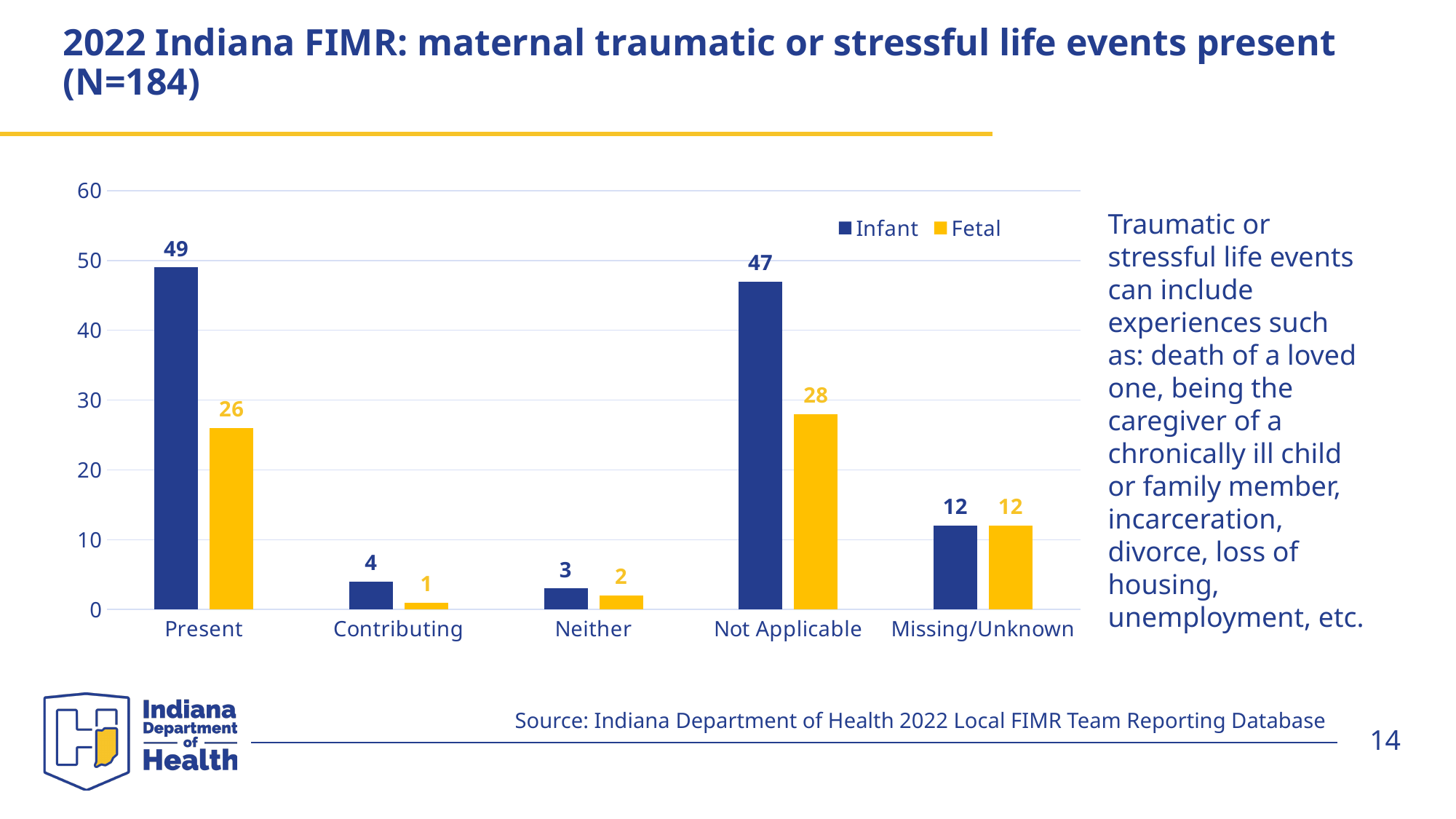
What is the Fetal value for the Contributing category? 1 How many series does the legend list? 2 What is the Fetal value for the Not Applicable category? 28 How many categories are shown on the x axis? 5 Which category has the lowest Fetal value? Contributing Which colour represents the Fetal series in the chart? Yellow What kind of chart is shown on the slide? Bar chart What is the total of the Infant and Fetal values for the Missing/Unknown category? 24 Which is larger, the Infant value for Not Applicable or the Fetal value for Not Applicable? Infant What is the difference between the Infant and Fetal values for the Present category? 23 What is the Infant value for the Present category? 49 Which category has the highest Infant value? Present